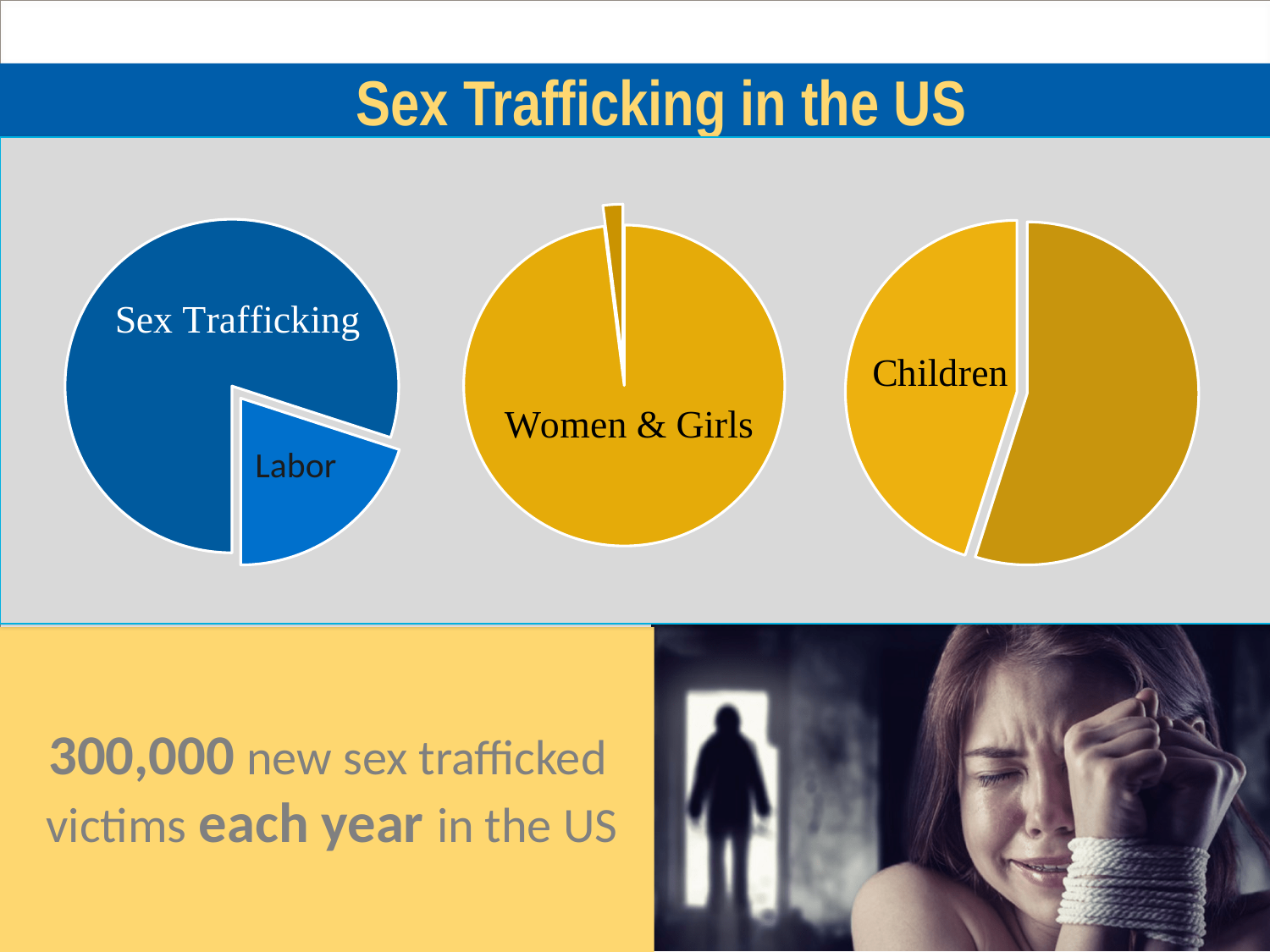
In the left pie chart, which slice is larger, Sex Trafficking or Labor? Sex Trafficking What is the label on the large slice of the middle pie chart? Women & Girls How many pie charts are shown on the slide? 3 In the left pie chart, which labeled slice is the largest? Sex Trafficking What kind of chart is the left chart on the slide? Pie chart In the left pie chart, which labeled slice is the smallest? Labor How many labeled slices does the left pie chart have? 2 What is the label shown on the right pie chart? Children In the middle pie chart, is the Women & Girls slice the larger or the smaller of the two slices? Larger What kind of chart is the right chart on the slide? Pie chart